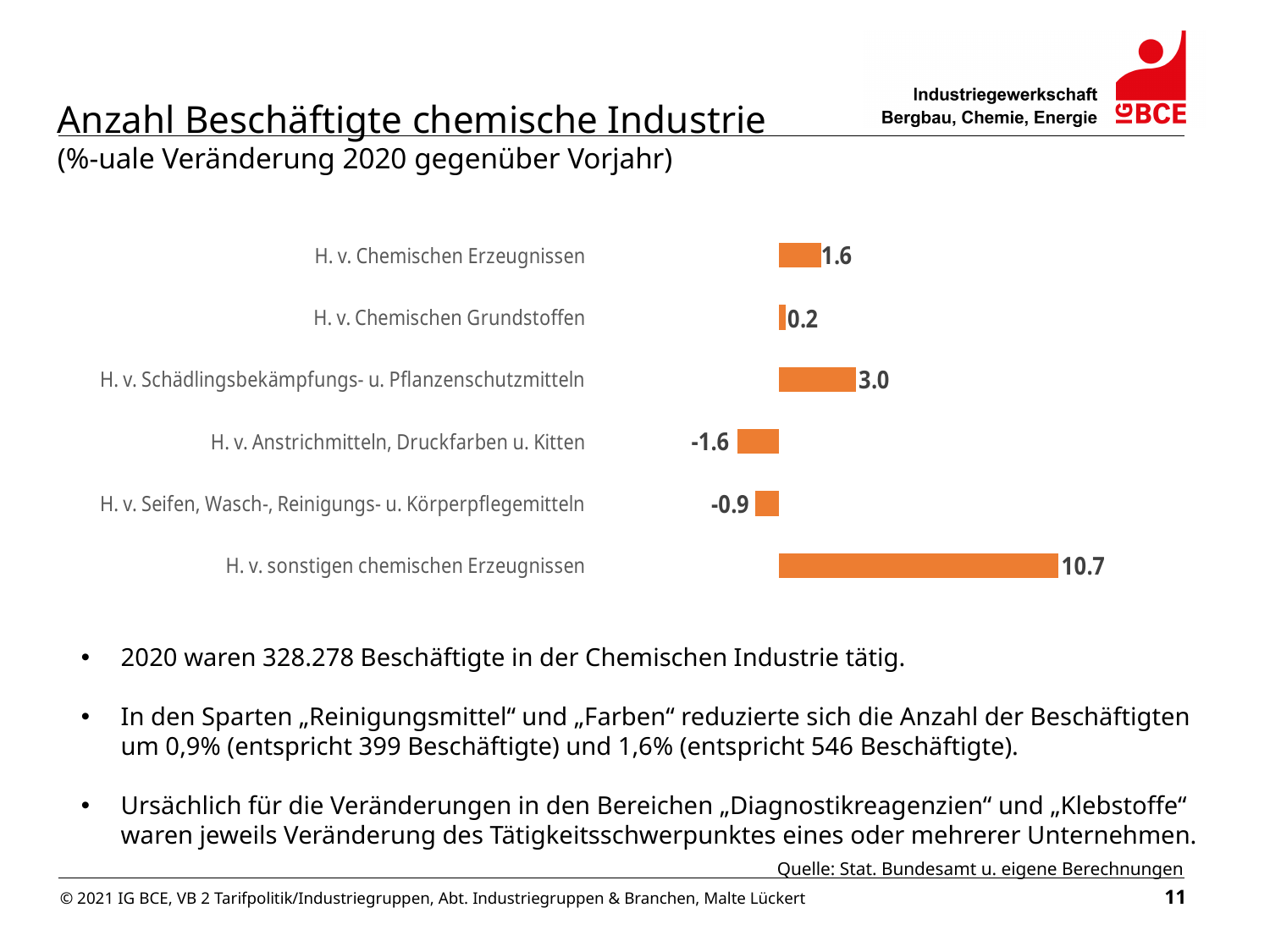
What kind of chart is shown on the slide? Bar chart What is the value for H. v. Chemischen Grundstoffen? 0.2 Which category has the highest value? H. v. sonstigen chemischen Erzeugnissen How many categories are shown in the chart? 6 Which category has the lowest value? H. v. Anstrichmitteln, Druckfarben u. Kitten What is the value for H. v. sonstigen chemischen Erzeugnissen? 10.7 What is the value for H. v. Chemischen Erzeugnissen? 1.6 What is the value for H. v. Schädlingsbekämpfungs- u. Pflanzenschutzmitteln? 3.0 What is the value for H. v. Seifen, Wasch-, Reinigungs- u. Körperpflegemitteln? -0.9 What is the value for H. v. Anstrichmitteln, Druckfarben u. Kitten? -1.6 What is the difference between the values for H. v. sonstigen chemischen Erzeugnissen and H. v. Schädlingsbekämpfungs- u. Pflanzenschutzmitteln? 7.7 Which is larger, the value for H. v. Chemischen Erzeugnissen or the value for H. v. Chemischen Grundstoffen? H. v. Chemischen Erzeugnissen